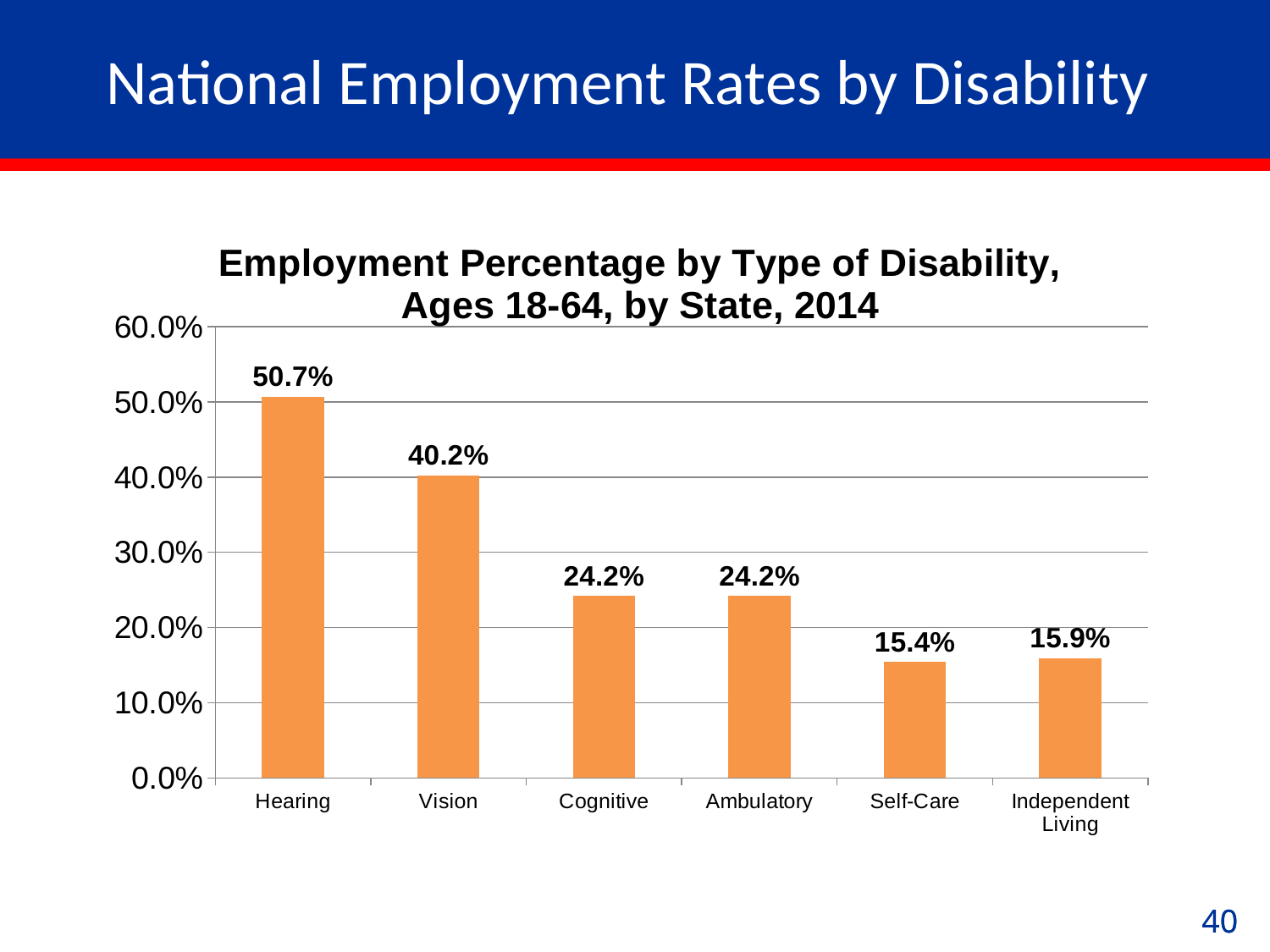
What is the difference between the employment percentages for Hearing and Vision? 10.5% What kind of chart is shown on the slide? Bar chart What is the employment percentage for Self-Care? 15.4% What is the title of the chart? Employment Percentage by Type of Disability, Ages 18-64, by State, 2014 Which type of disability has the highest employment percentage? Hearing What is the difference between the employment percentages for Independent Living and Self-Care? 0.5% What is the employment percentage for Independent Living? 15.9% Which has a higher employment percentage, Vision or Cognitive? Vision What is the employment percentage for Hearing? 50.7% Which type of disability has the lowest employment percentage? Self-Care What is the employment percentage for Vision? 40.2% How many types of disability are shown on the chart? 6